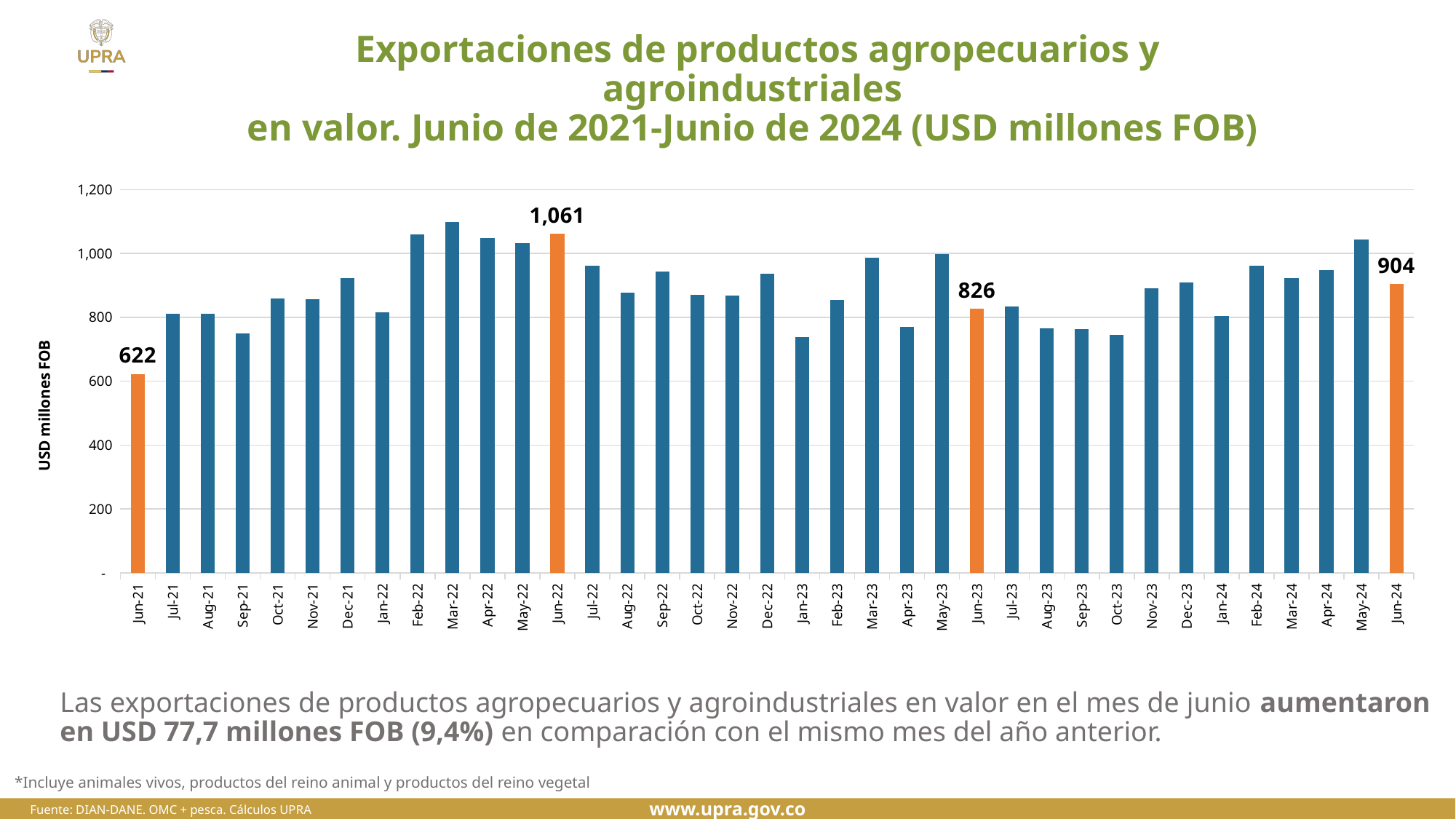
What is the value for Jun-24? 904 What is the difference between the values for Jun-24 and Jun-23? 78 Which month has the lowest value in the chart? Jun-21 What is the difference between the values for Jun-22 and Jun-21? 439 What is the value for Jun-23? 826 Which is larger, the value for Jun-22 or the value for Jun-24? Jun-22 What kind of chart is shown on the slide? bar chart What is the value for Jun-22? 1,061 What is the value for Jun-21? 622 Is the value for Jan-23 greater or less than 800? less How many monthly bars are plotted in the chart? 37 Which month has the highest value in the chart? Mar-22